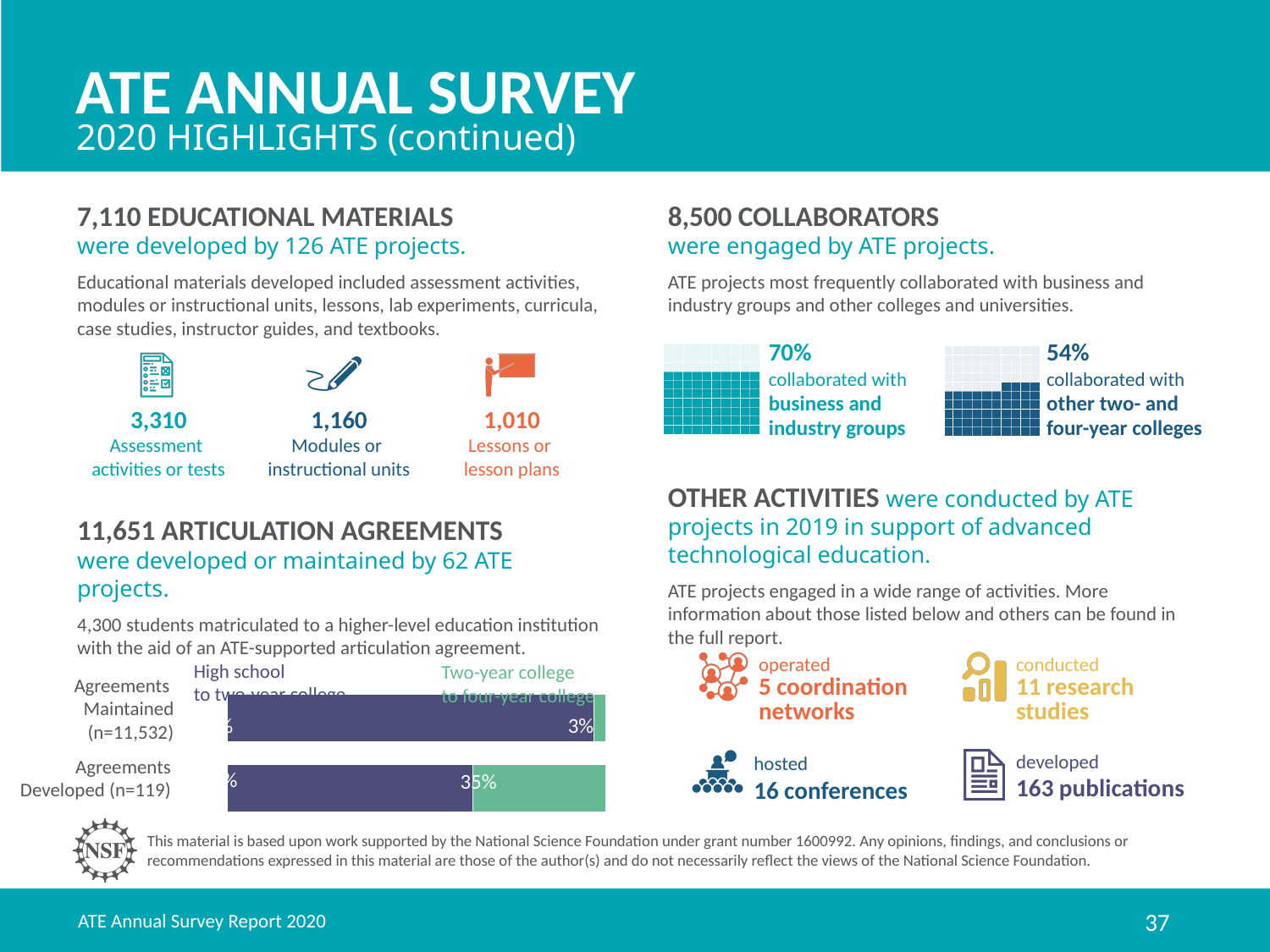
In the articulation agreements bar chart, how many categories are shown? 2 In the articulation agreements bar chart, which series makes up the larger part of the Agreements Developed bar? High school to two-year college In the articulation agreements bar chart, what is the Two-year college to four-year college share for Agreements Developed (n=119)? 35% In the articulation agreements bar chart, what is the n value shown for Agreements Maintained? 11,532 What kind of chart is the articulation agreements chart at the bottom left of the slide? bar chart In the collaborators section, what percentage of ATE projects collaborated with business and industry groups? 70% In the articulation agreements bar chart, what is the Two-year college to four-year college share for Agreements Maintained (n=11,532)? 3% In the articulation agreements bar chart, which series makes up the larger part of the Agreements Maintained bar? High school to two-year college In the articulation agreements bar chart, what is the difference between the Two-year college to four-year college shares for Agreements Developed and Agreements Maintained? 32 percentage points In the articulation agreements bar chart, what colour represents the Two-year college to four-year college series? green In the articulation agreements bar chart, how many series are shown? 2 In the articulation agreements bar chart, which category has the larger Two-year college to four-year college share? Agreements Developed (n=119)